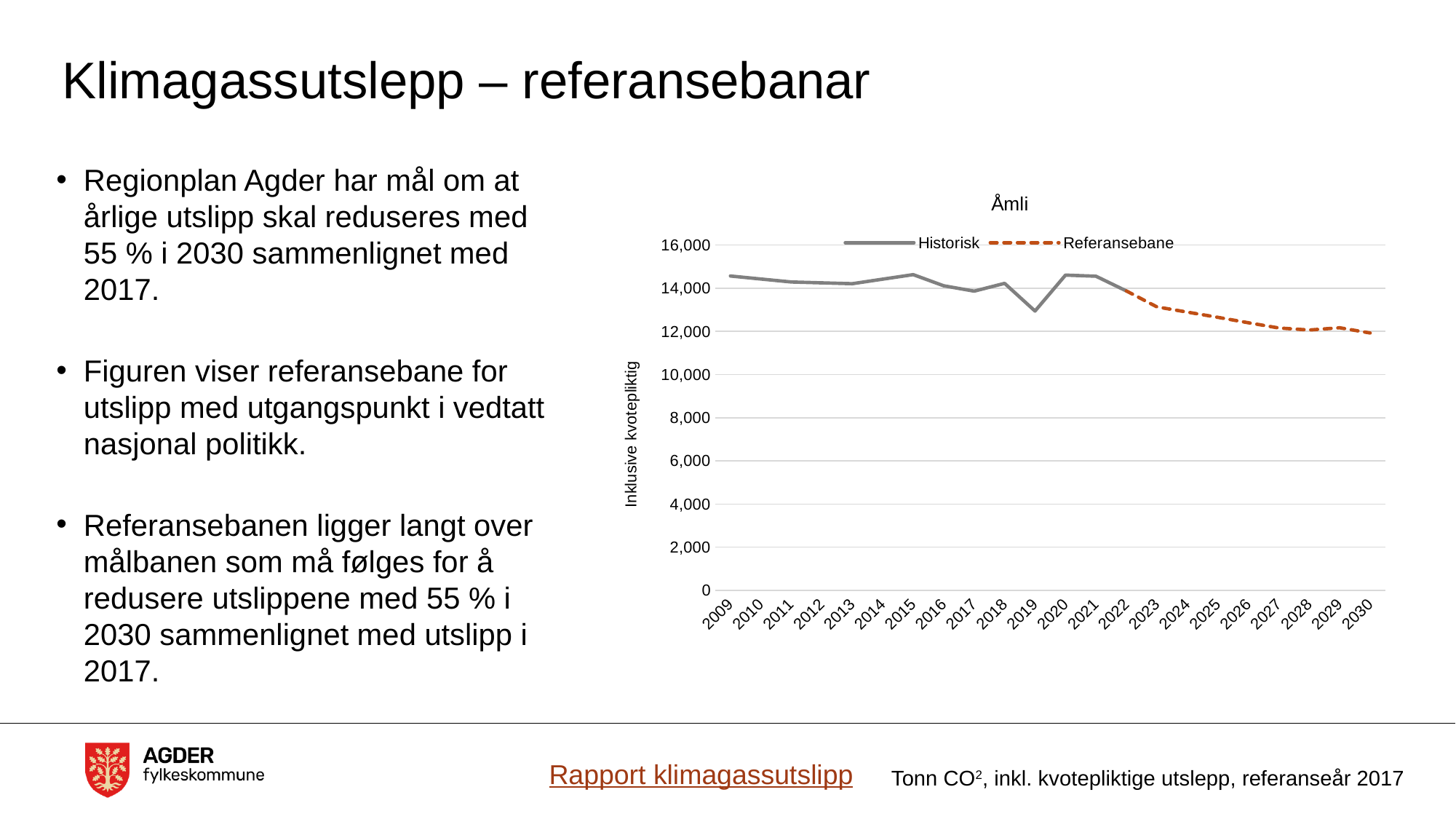
Is the Historisk value for 2019 greater or less than 14,000? less Which series is drawn with a dashed line? Referansebane How many years are shown along the x axis of the chart? 22 Is the Referansebane value for 2023 greater or less than 12,000? greater How many series does the chart legend list? 2 Does the Referansebane series rise or fall from 2022 to 2030? fall Is the Historisk value for 2009 greater or less than 14,000? greater What is the title of the chart? Åmli In which year does the Historisk series reach its lowest value? 2019 Which year has the larger Historisk value, 2019 or 2020? 2020 What kind of chart is shown on the slide? line chart